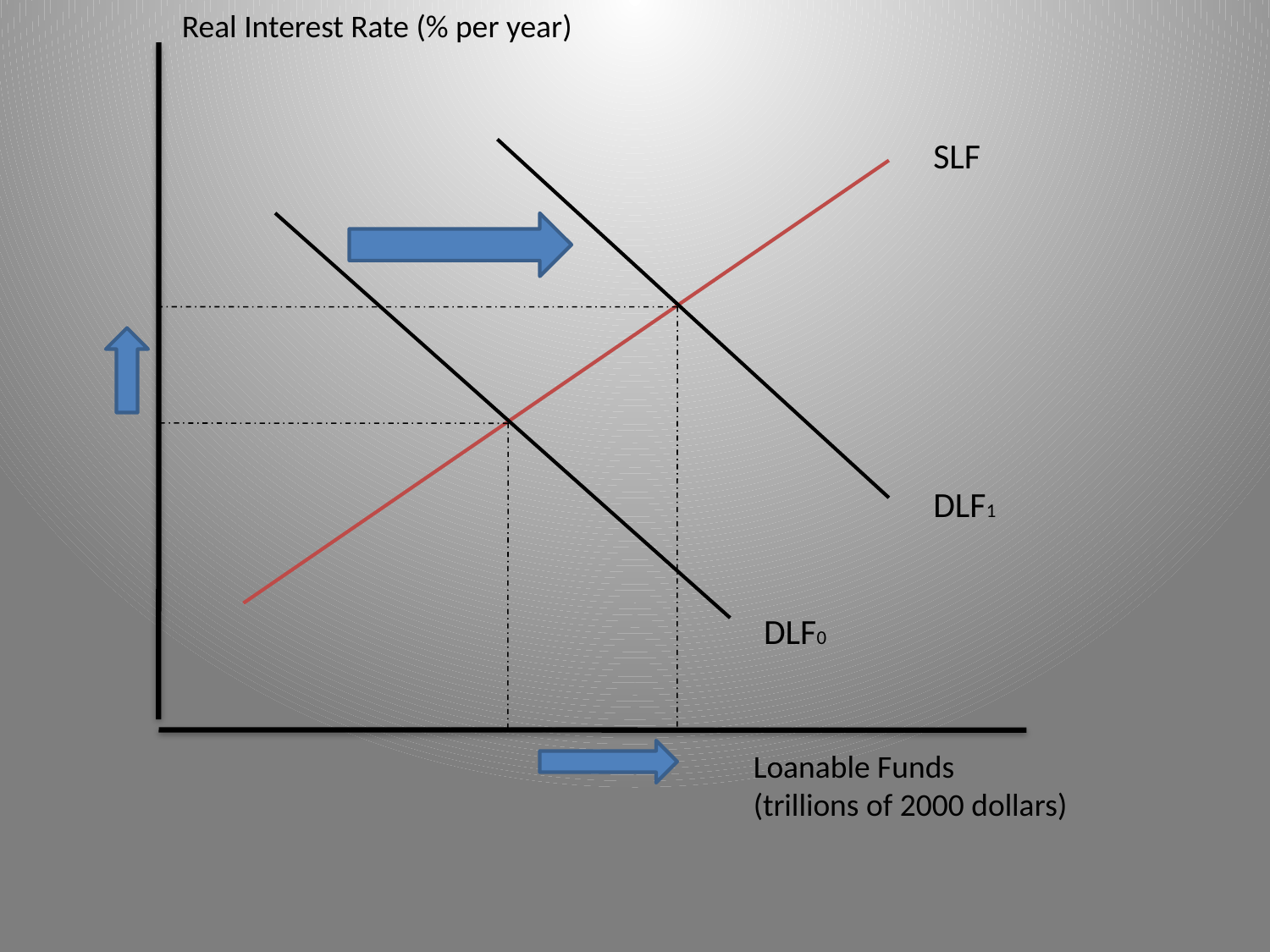
How many curves in total are drawn on the chart? 3 What is the label of the vertical axis? Real Interest Rate (% per year) How many demand-for-loanable-funds (DLF) curves are drawn on the chart? 2 Which curve is drawn in red? SLF What is the label of the horizontal axis? Loanable Funds (trillions of 2000 dollars) Is the equilibrium quantity of loanable funds larger at the DLF1 intersection or the DLF0 intersection with SLF? DLF1 intersection Does the DLF1 curve rise or fall as loanable funds increase along the x axis? fall Does the SLF curve rise or fall as loanable funds increase along the x axis? rise Which of the two demand curves lies further to the right, DLF0 or DLF1? DLF1 Does the DLF0 curve rise or fall as loanable funds increase along the x axis? fall